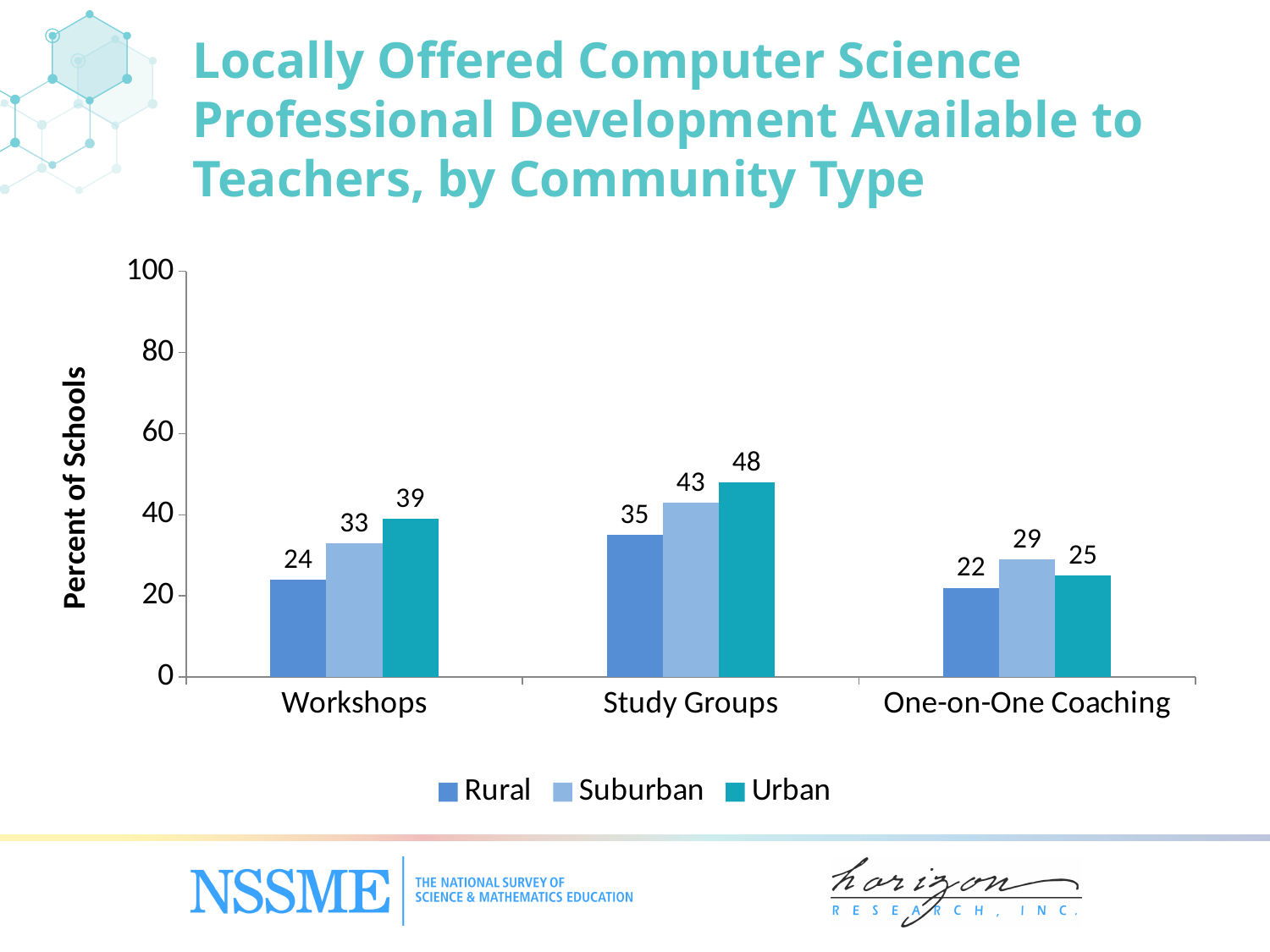
What is the value for Urban in the Study Groups category? 48 What percent of schools in rural communities have locally offered workshops available? 24 Which community type has the lowest value for One-on-One Coaching? Rural How many series does the legend list? 3 Is the Urban value for Study Groups greater or less than 40? greater What is the value for Suburban in the One-on-One Coaching category? 29 What is the label of the y axis? Percent of Schools How many categories are shown on the x axis? 3 Which is larger: the Suburban value for Workshops or the Suburban value for Study Groups? Study Groups What is the difference between the Urban and Rural values for Study Groups? 13 Which community type has the highest value for Workshops? Urban What kind of chart is shown on the slide? Bar chart